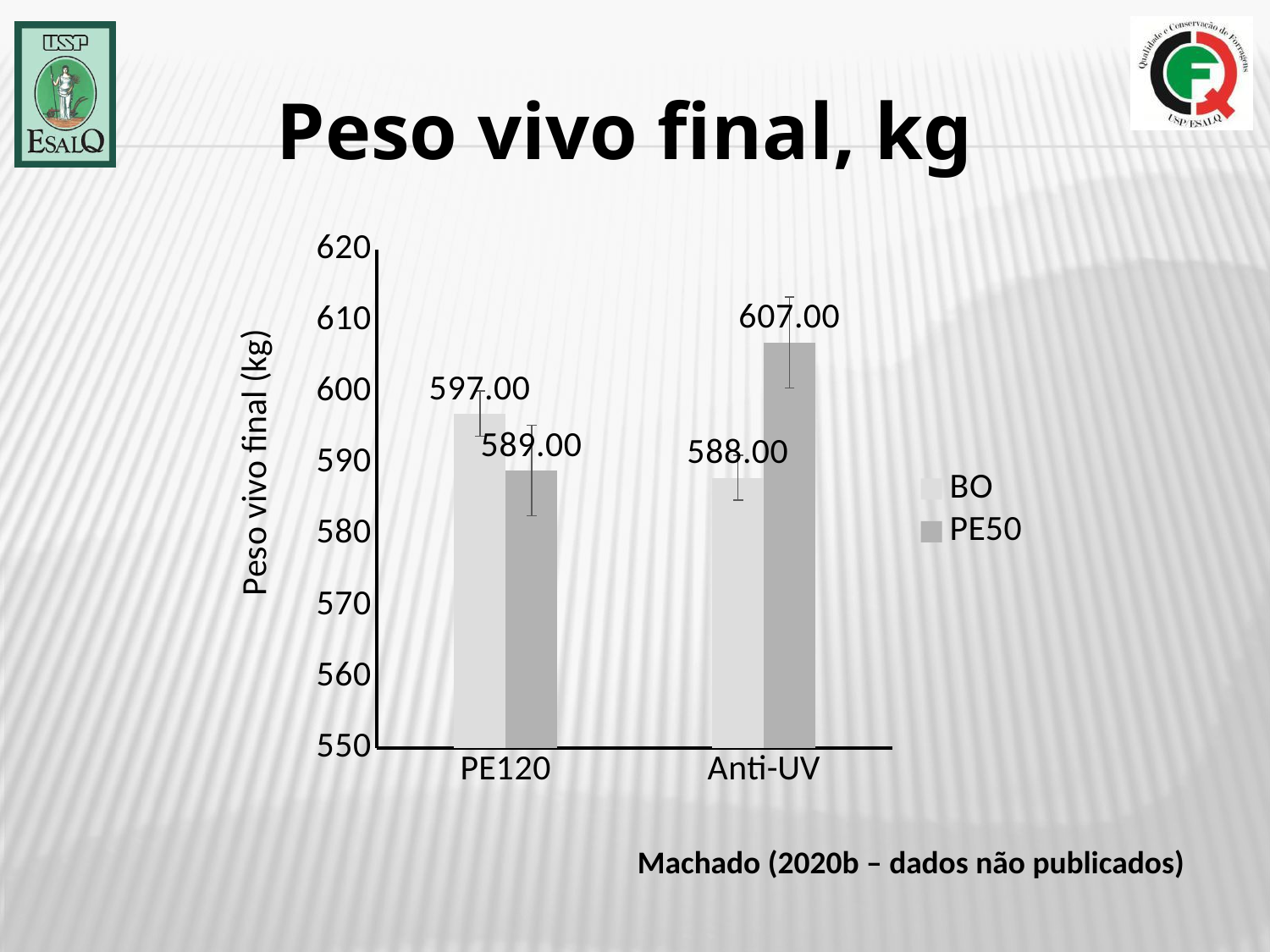
What is the value for BO in the Anti-UV category? 588.00 What is the value for BO in the PE120 category? 597.00 How many series does the legend list? 2 Which bar has the highest value on the chart? PE50 in Anti-UV How many categories are shown on the x axis? 2 What kind of chart is shown on the slide? Bar chart What is the value for PE50 in the Anti-UV category? 607.00 Which bar has the lowest value on the chart? BO in Anti-UV What is the value for PE50 in the PE120 category? 589.00 In the Anti-UV category, which series has the larger value, BO or PE50? PE50 What is the difference between the BO and PE50 values in the PE120 category? 8.00 What is the difference between the PE50 value in Anti-UV and the PE50 value in PE120? 18.00